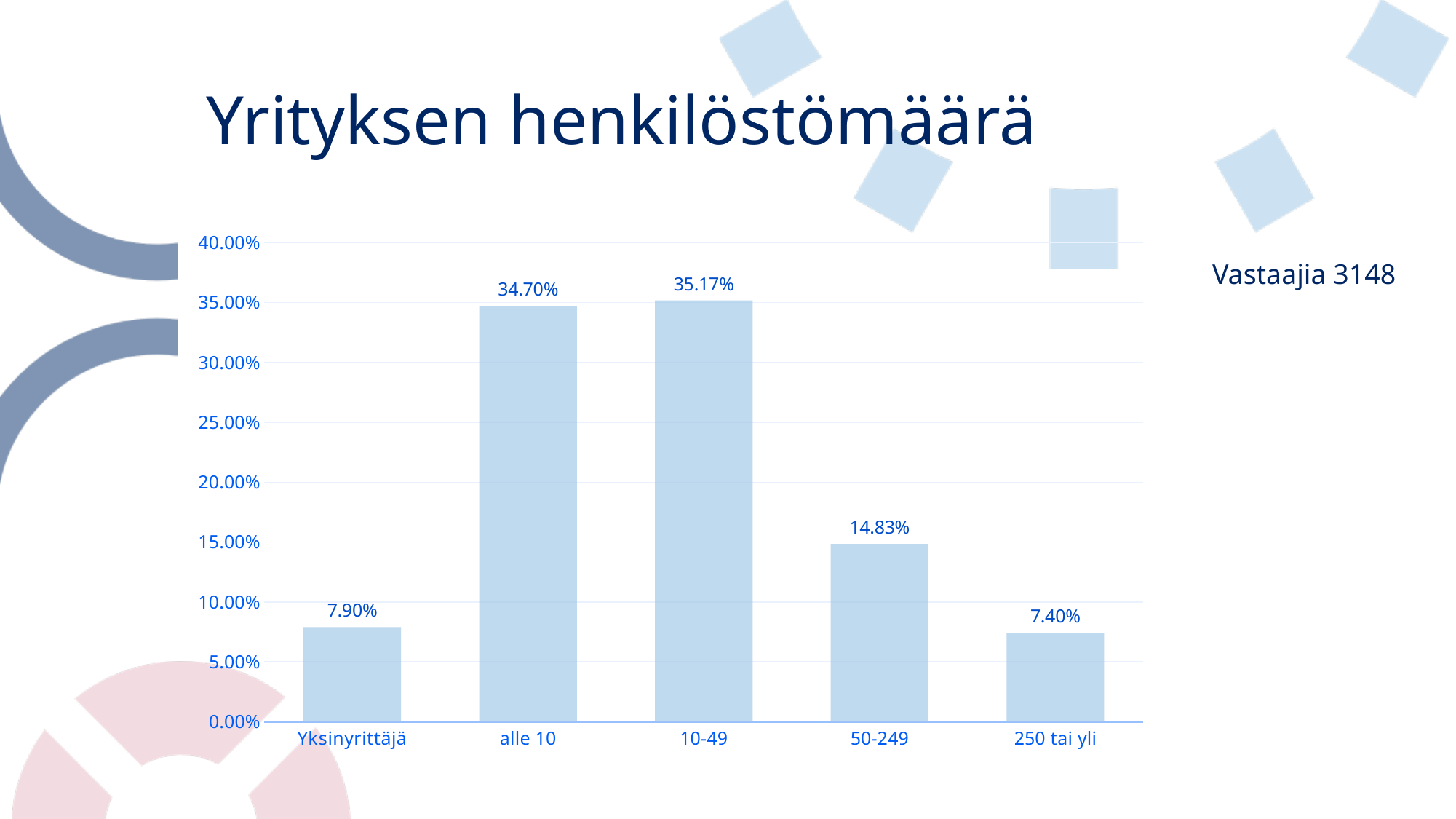
Which category has the highest value? 10-49 How many respondents (Vastaajia) are stated on the slide? 3148 What is the title of the slide? Yrityksen henkilöstömäärä What is the value for 'Yksinyrittäjä'? 7.90% Is the value for '50-249' greater or less than 10.00%? greater What is the value for 'alle 10'? 34.70% What is the value for '50-249'? 14.83% How many categories are shown on the x axis? 5 Which is larger, the value for 'Yksinyrittäjä' or the value for '250 tai yli'? Yksinyrittäjä What is the difference between the values for '10-49' and '50-249'? 20.34% What kind of chart is shown on the slide? bar chart Which category has the lowest value? 250 tai yli